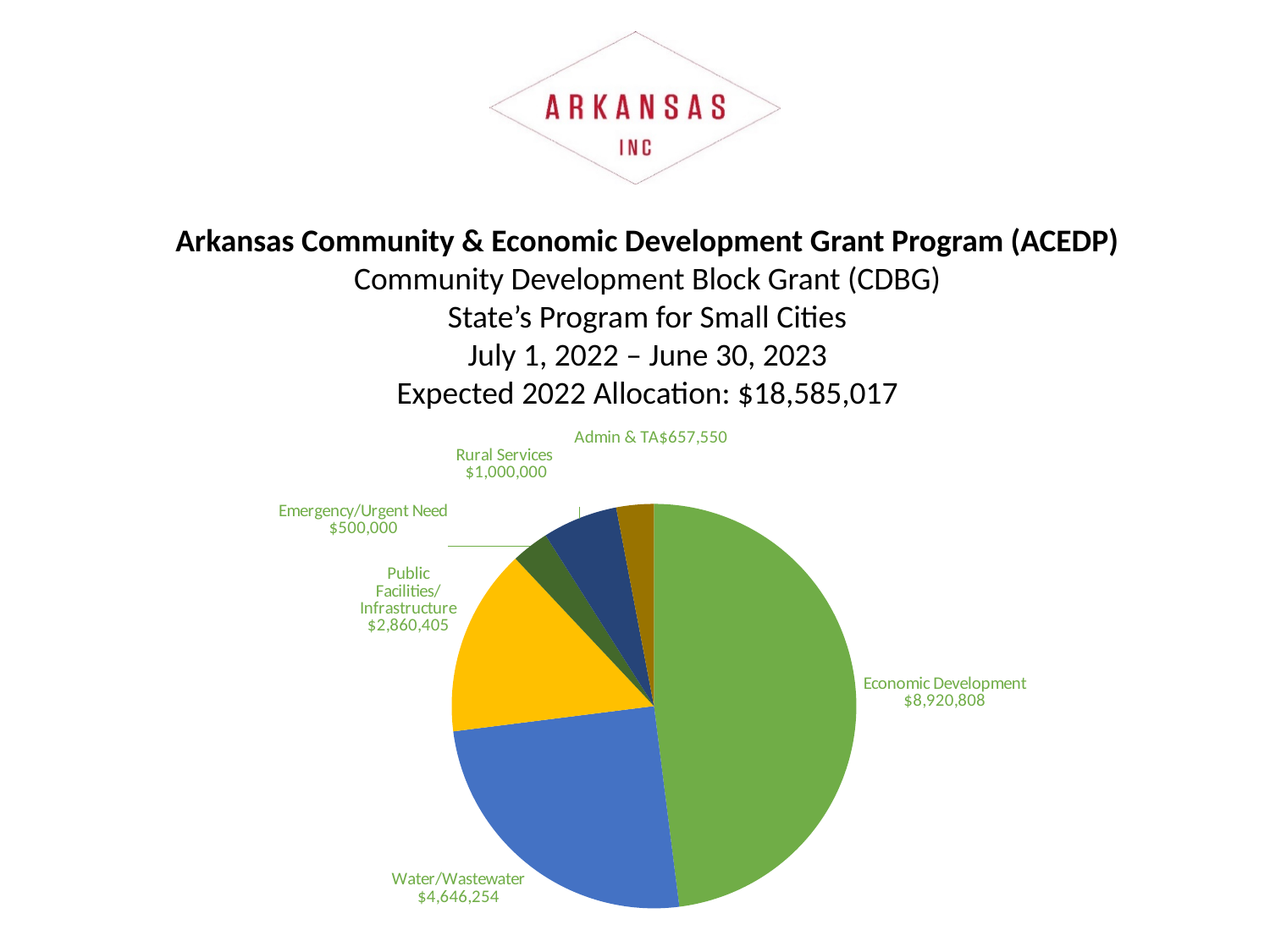
Which category has the largest slice of the pie? Economic Development What is the difference between Economic Development and Water/Wastewater? $4,274,554 What share of the total pie does Water/Wastewater represent? 25% What is the value for Admin & TA? $657,550 What is the value for Water/Wastewater? $4,646,254 What is the difference between Rural Services and Emergency/Urgent Need? $500,000 What kind of chart is shown on the slide? pie chart Which category has the smallest slice of the pie? Emergency/Urgent Need What is the value for Public Facilities/Infrastructure? $2,860,405 How many slices does the pie chart have? 6 Which is larger, Rural Services or Admin & TA? Rural Services What is the value for Economic Development? $8,920,808